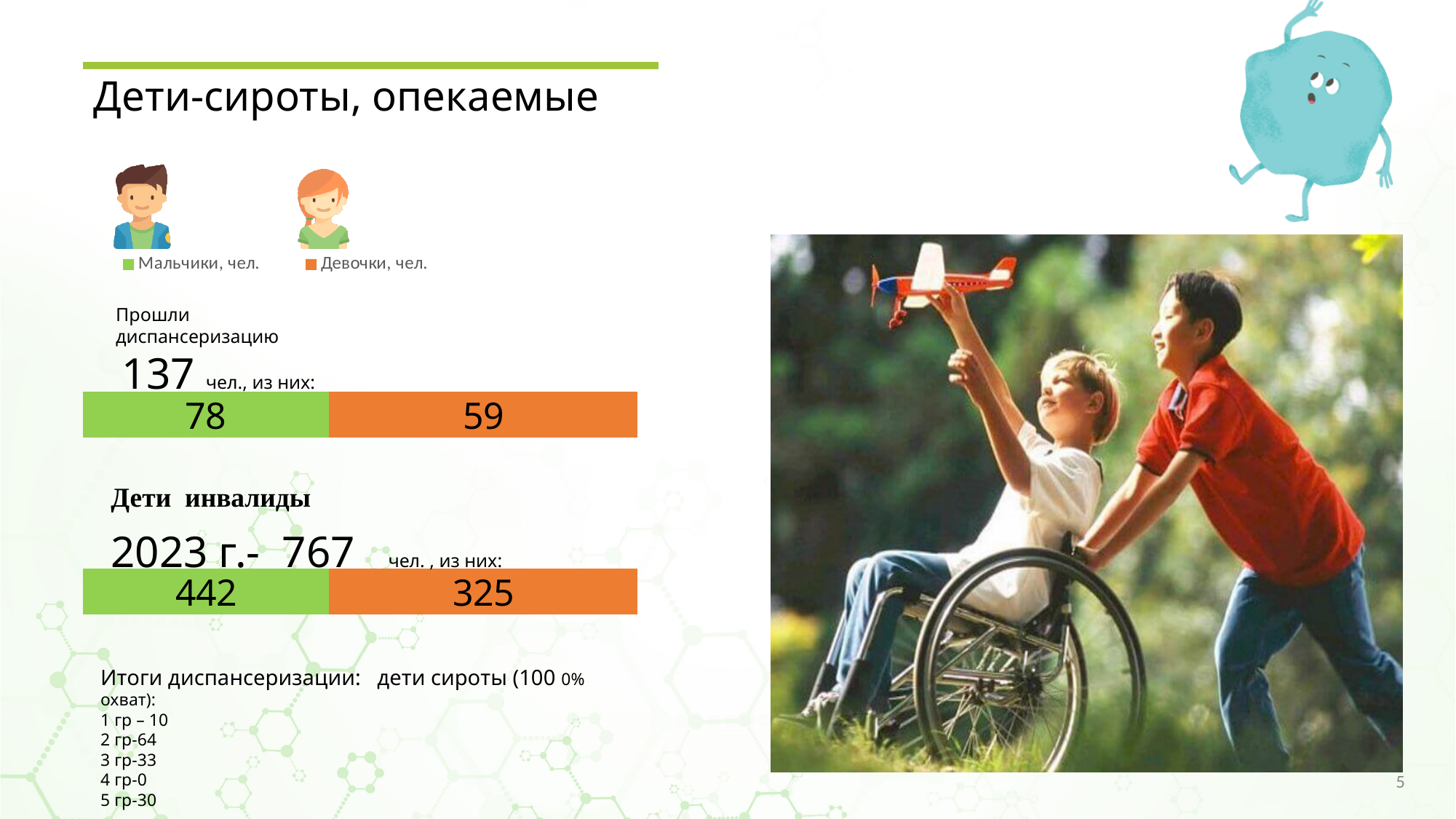
What is the total of the stacked bar in the lower chart (Дети инвалиды, 2023 г.)? 767 What colour represents Девочки, чел. in the bar charts? Orange What is the total of the stacked bar in the upper chart (Прошли диспансеризацию)? 137 In the upper bar chart (Прошли диспансеризацию), what is the value for Девочки, чел.? 59 In the upper bar chart (Прошли диспансеризацию), what is the value for Мальчики, чел.? 78 In the upper bar chart (Прошли диспансеризацию), which series has the larger value, Мальчики or Девочки? Мальчики In the lower bar chart (Дети инвалиды, 2023 г.), which series has the smaller value? Девочки, чел. In the upper bar chart (Прошли диспансеризацию), what is the difference between the Мальчики and Девочки values? 19 How many series does the legend list for the bar charts on this slide? 2 In the lower bar chart (Дети инвалиды, 2023 г.), what is the value for Мальчики, чел.? 442 In the lower bar chart (Дети инвалиды, 2023 г.), what is the difference between the Мальчики and Девочки values? 117 In the lower bar chart (Дети инвалиды, 2023 г.), what is the value for Девочки, чел.? 325